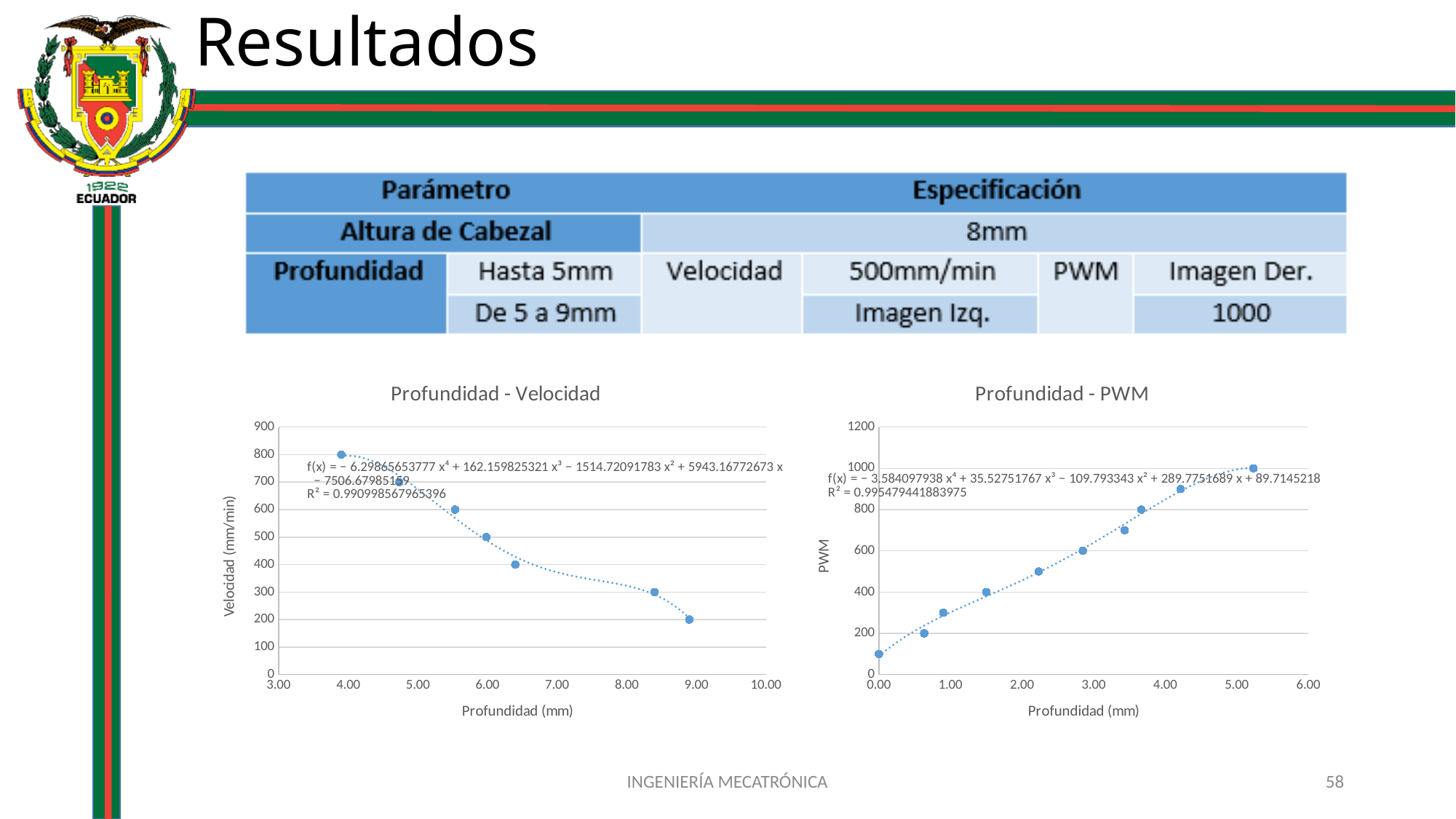
In the 'Profundidad - PWM' chart, do the PWM values rise or fall as Profundidad increases? rise What is the y-axis title of the 'Profundidad - Velocidad' chart? Velocidad (mm/min) In the 'Profundidad - PWM' chart, is the PWM value of the point at the largest depth greater or less than 800? greater What type of chart is the 'Profundidad - Velocidad' chart? scatter chart How many data points are plotted in the 'Profundidad - PWM' chart? 10 What is the R² value shown on the 'Profundidad - PWM' chart? 0.995479441883975 In the 'Profundidad - PWM' chart, is the PWM value of the point at depth 0.00 greater or less than 200? less In the 'Profundidad - Velocidad' chart, is the velocity of the point at the largest depth greater or less than 300? less In the 'Profundidad - Velocidad' chart, do the values rise or fall as Profundidad increases? fall How many data points are plotted in the 'Profundidad - Velocidad' chart? 7 In the 'Profundidad - PWM' chart, which point has the higher PWM value: the one at the largest depth or the one at the smallest depth? the one at the largest depth